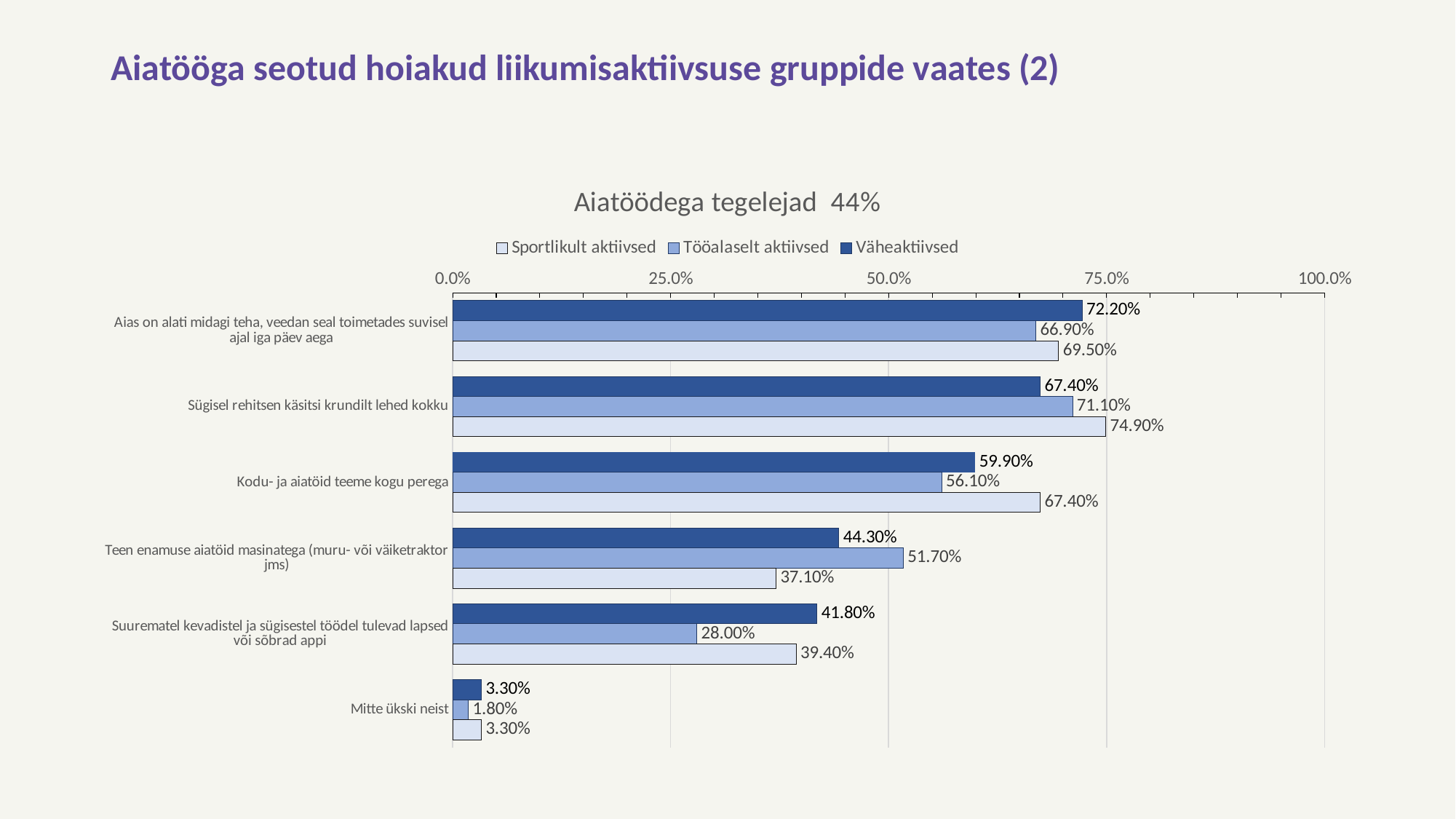
What is the value for Sportlikult aktiivsed for 'Sügisel rehitsen käsitsi krundilt lehed kokku'? 74.90% What is the value for Väheaktiivsed for 'Aias on alati midagi teha, veedan seal toimetades suvisel ajal iga päev aega'? 72.20% What is the value for Tööalaselt aktiivsed for 'Suurematel kevadistel ja sügisestel töödel tulevad lapsed või sõbrad appi'? 28.00% What kind of chart is shown on the slide? bar chart For 'Kodu- ja aiatöid teeme kogu perega', which is larger: the Väheaktiivsed value or the Tööalaselt aktiivsed value? Väheaktiivsed How many series does the legend list? 3 Is the Väheaktiivsed value for 'Suurematel kevadistel ja sügisestel töödel tulevad lapsed või sõbrad appi' greater or less than 50.0%? less What is the title of the chart? Aiatöödega tegelejad 44% Which category has the highest value for Sportlikult aktiivsed? Sügisel rehitsen käsitsi krundilt lehed kokku What is the difference between the Tööalaselt aktiivsed and Sportlikult aktiivsed values for 'Teen enamuse aiatöid masinatega (muru- või väiketraktor jms)'? 14.60% Which category has the lowest value for Väheaktiivsed? Mitte ükski neist How many categories are shown on the chart? 6